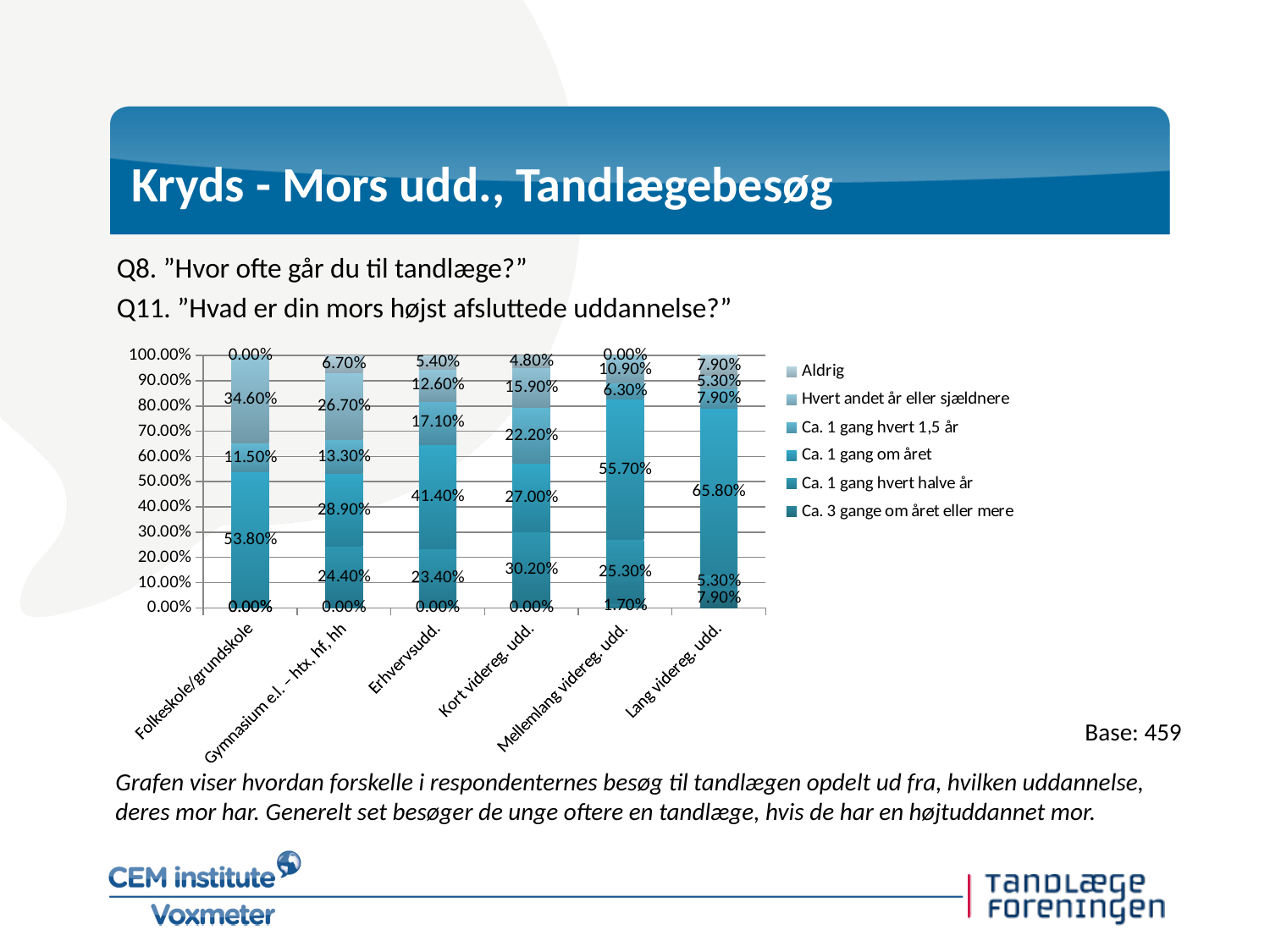
What is the value of the 'Ca. 3 gange om året eller mere' segment for 'Mellemlang videreg. udd.'? 1.70% Which category has the highest 'Ca. 3 gange om året eller mere' share? Lang videreg. udd. What is the value of the largest segment in the 'Lang videreg. udd.' bar? 65.80% What is the value of the largest segment in the 'Folkeskole/grundskole' bar? 53.80% What is the base (number of respondents) stated on the slide? 459 Which has a larger 'Aldrig' value, 'Erhvervsudd.' or 'Kort videreg. udd.'? Erhvervsudd. What type of chart is shown on the slide? Stacked bar chart Which category has the highest 'Aldrig' share? Lang videreg. udd. What is the difference between the 'Aldrig' values for 'Gymnasium e.l. – htx, hf, hh' and 'Kort videreg. udd.'? 1.90 percentage points How many series does the legend list? 6 What is the value of the 'Aldrig' segment for 'Gymnasium e.l. – htx, hf, hh'? 6.70% How many education categories are shown on the x axis? 6